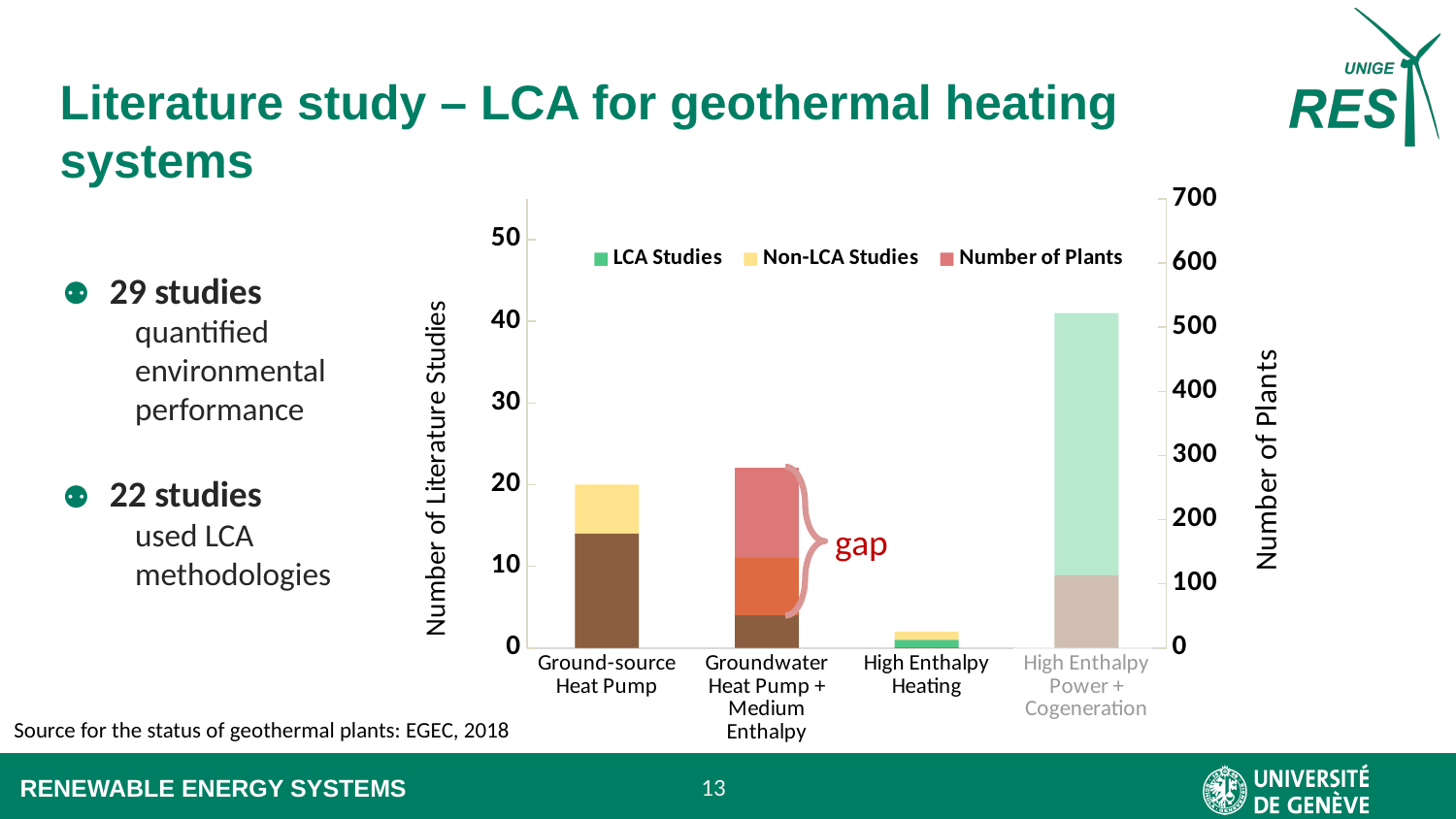
Which bar is taller: Ground-source Heat Pump or High Enthalpy Heating? Ground-source Heat Pump How many categories are shown on the x axis of the chart? 4 How many series does the chart legend list? 3 Is the top of the High Enthalpy Power + Cogeneration bar greater or less than 30 on the left axis? greater Is the top of the Groundwater Heat Pump + Medium Enthalpy bar greater or less than 10 on the left axis? greater Which category has the tallest bar in the chart? High Enthalpy Power + Cogeneration Is the total height of the High Enthalpy Heating bar greater or less than 10 on the left axis? less What is the title of the left vertical axis of the chart? Number of Literature Studies What kind of chart is shown on the slide? stacked bar chart What are the three series listed in the chart legend? LCA Studies, Non-LCA Studies, Number of Plants Which category has the shortest bar in the chart? High Enthalpy Heating